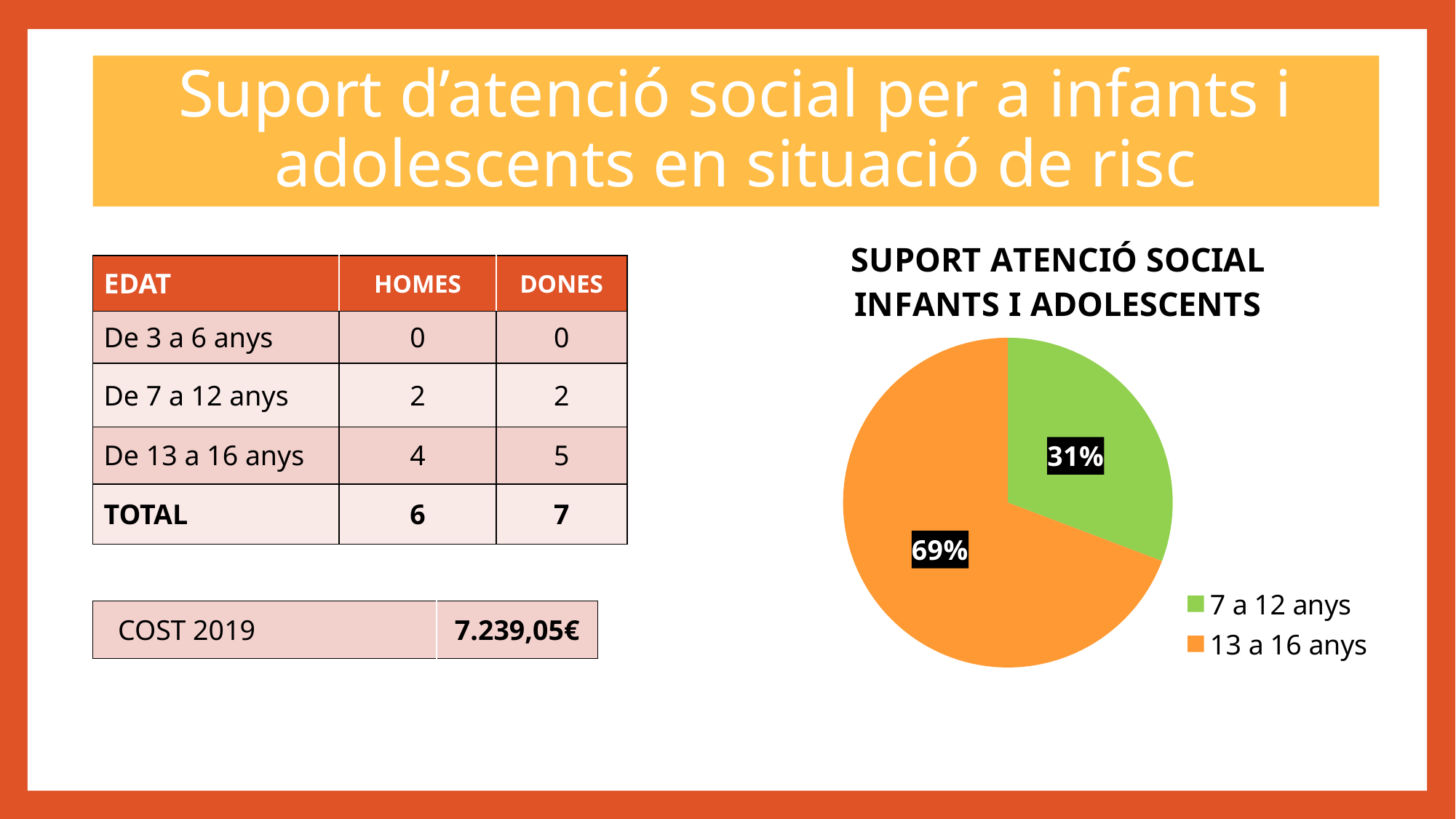
What is the difference in percentage points between the '13 a 16 anys' slice and the '7 a 12 anys' slice? 38 How many slices does the pie chart have? 2 Is the share of the '7 a 12 anys' slice greater or less than 50%? less What is the title of the pie chart? SUPORT ATENCIÓ SOCIAL INFANTS I ADOLESCENTS How many entries does the pie chart legend list? 2 Which slice of the pie chart is the largest? 13 a 16 anys Which slice of the pie chart is the smallest? 7 a 12 anys What colour is the '13 a 16 anys' slice in the pie chart? orange What kind of chart is shown on the slide? pie chart What percentage does the '7 a 12 anys' slice show in the pie chart? 31% Which is larger in the pie chart, the '7 a 12 anys' slice or the '13 a 16 anys' slice? 13 a 16 anys What percentage does the '13 a 16 anys' slice show in the pie chart? 69%